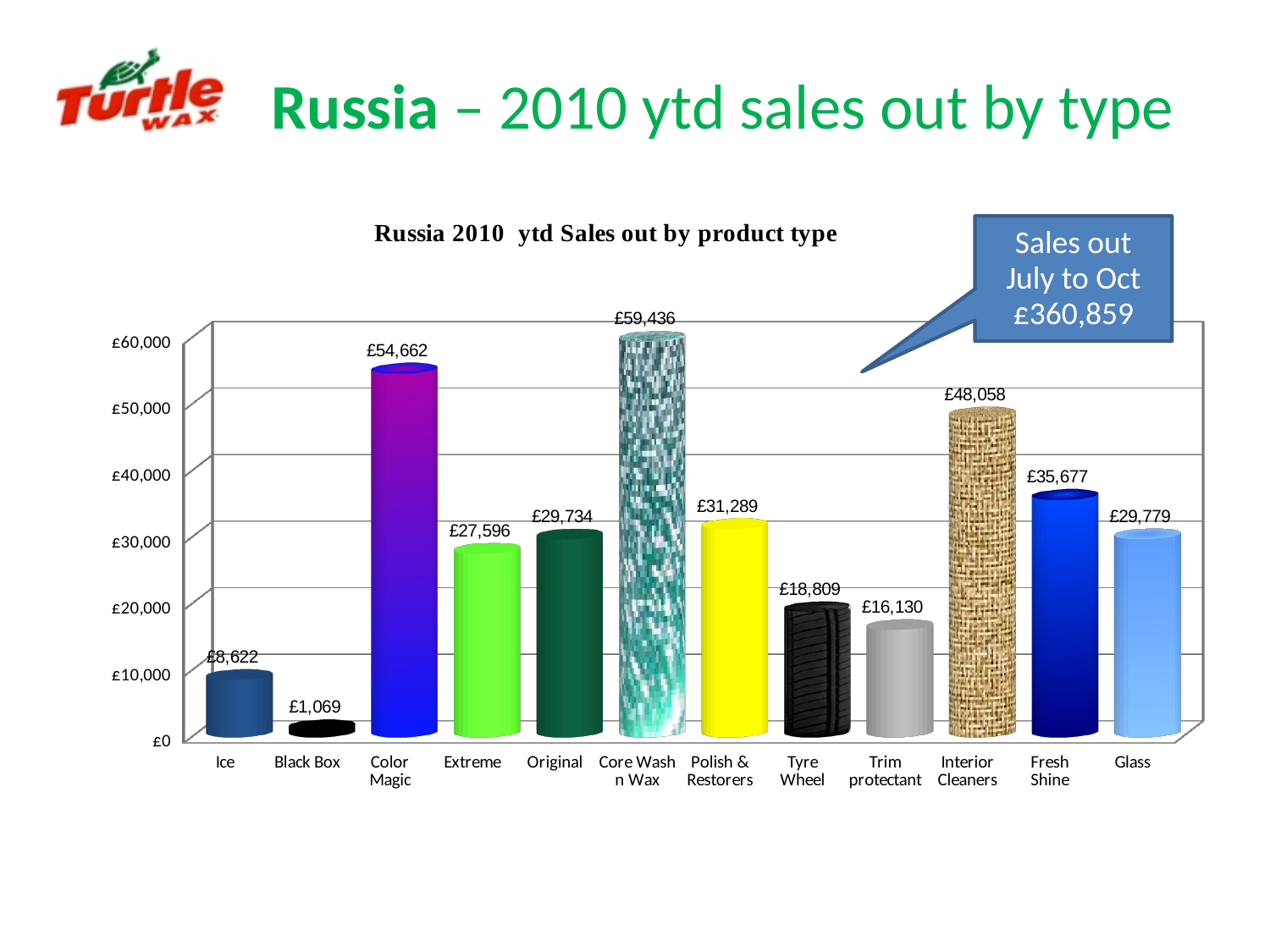
What is the difference between Core Wash n Wax and Color Magic? £4,774 How many product types are shown in the chart? 12 Which product type has the highest sales out? Core Wash n Wax What is the value for Trim protectant? £16,130 Is the value for Extreme greater or less than £30,000? less What is the difference between Fresh Shine and Glass? £5,898 What is the title of the chart? Russia 2010 ytd Sales out by product type What is the value for Interior Cleaners? £48,058 What is the value for Color Magic? £54,662 What kind of chart is shown on the slide? bar chart Which product type has the lowest sales out? Black Box Which is larger, Polish & Restorers or Tyre Wheel? Polish & Restorers